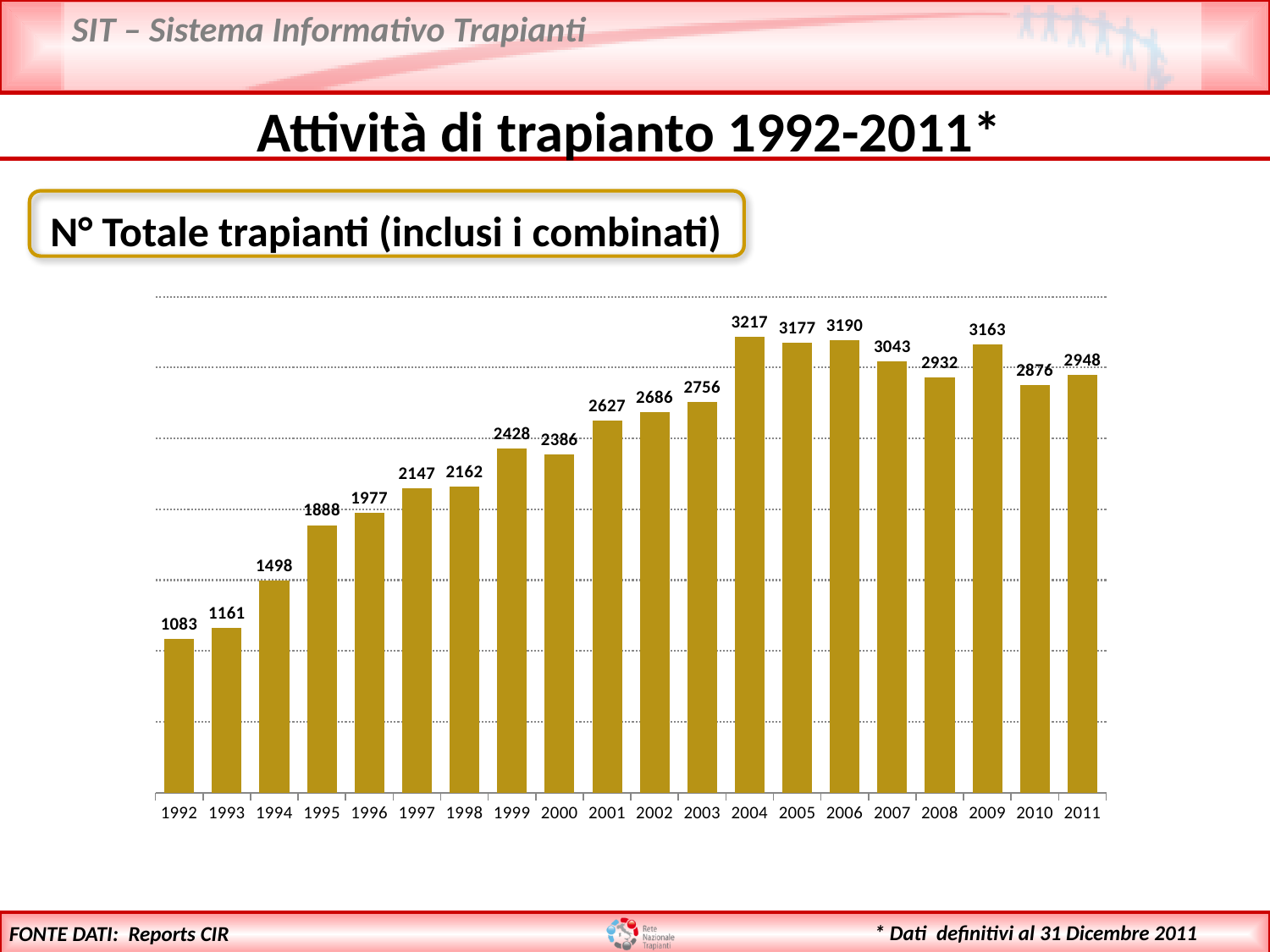
Which is larger, the value for 2006 or the value for 2005? 2006 What is the difference between the values for 2011 and 2010? 72 What is the difference between the values for 2004 and 1992? 2134 How many years are shown on the x axis? 20 What is the value for 1992? 1083 Which year has the lowest value? 1992 What kind of chart is shown? bar chart What is the value for 2011? 2948 Which year has the highest value? 2004 Do the values rise or fall from 1992 to 2004? rise What is the value for 2004? 3217 What is the value for 1999? 2428